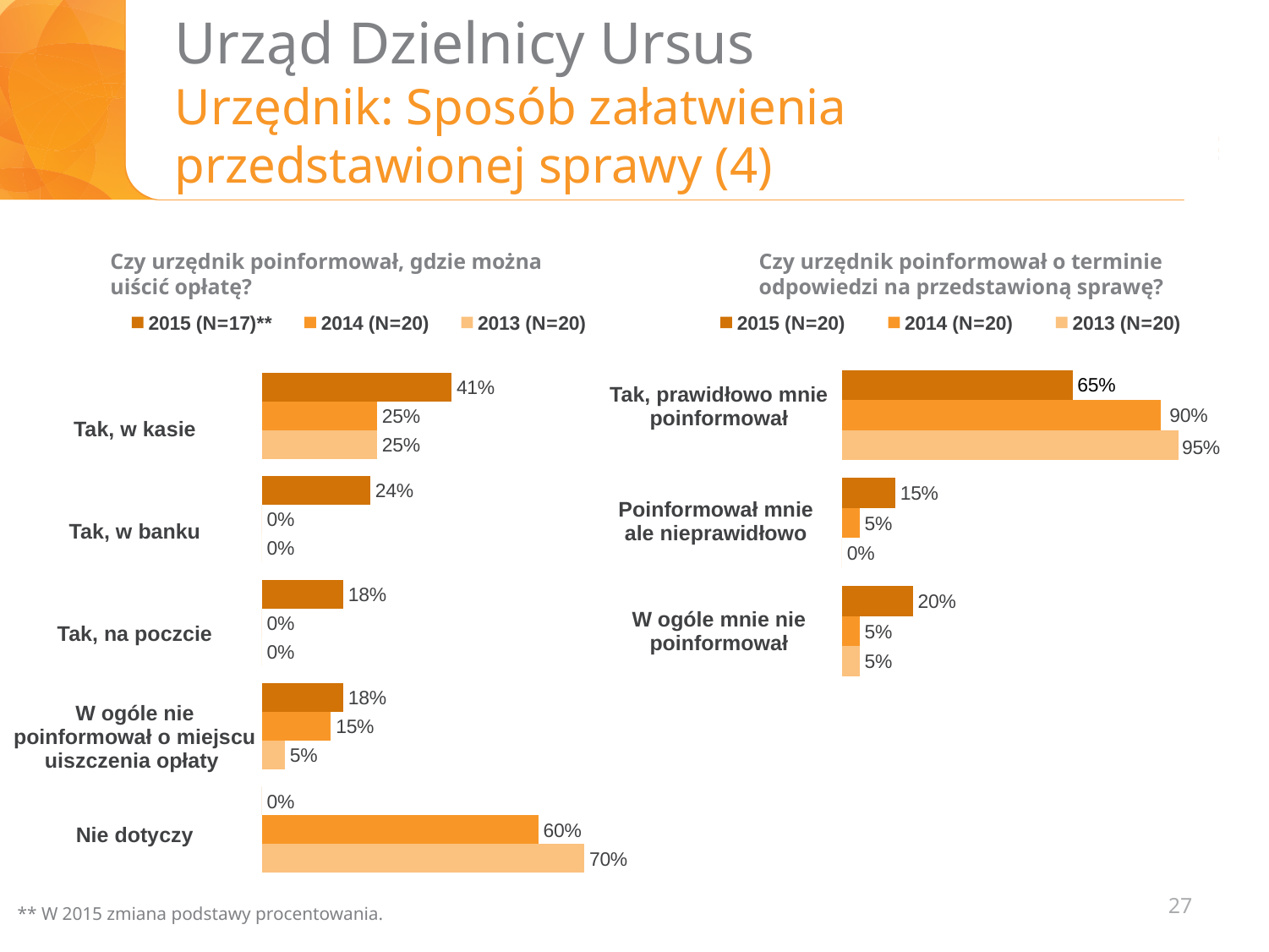
In the left chart, what is the 2013 value for "Nie dotyczy"? 70% In the left chart, what is the 2014 value for "W ogóle nie poinformował o miejscu uiszczenia opłaty"? 15% In the left chart, which category has the highest 2015 value? Tak, w kasie In the left chart ("Czy urzędnik poinformował, gdzie można uiścić opłatę?"), what is the 2015 value for "Tak, w kasie"? 41% In the right chart, which is larger for "Poinformował mnie ale nieprawidłowo": the 2015 value or the 2014 value? 2015 What type of chart is the left chart? Bar chart In the right chart, what is the 2015 value for "W ogóle mnie nie poinformował"? 20% How many series does the legend of the right chart list? 3 In the right chart, what is the difference between the 2013 and 2015 values for "Tak, prawidłowo mnie poinformował"? 30% In the right chart ("Czy urzędnik poinformował o terminie odpowiedzi na przedstawioną sprawę?"), what is the 2013 value for "Tak, prawidłowo mnie poinformował"? 95% In the left chart, how many categories are shown? 5 In the left chart, what is the difference between the 2014 and 2015 values for "Tak, w kasie"? 16%